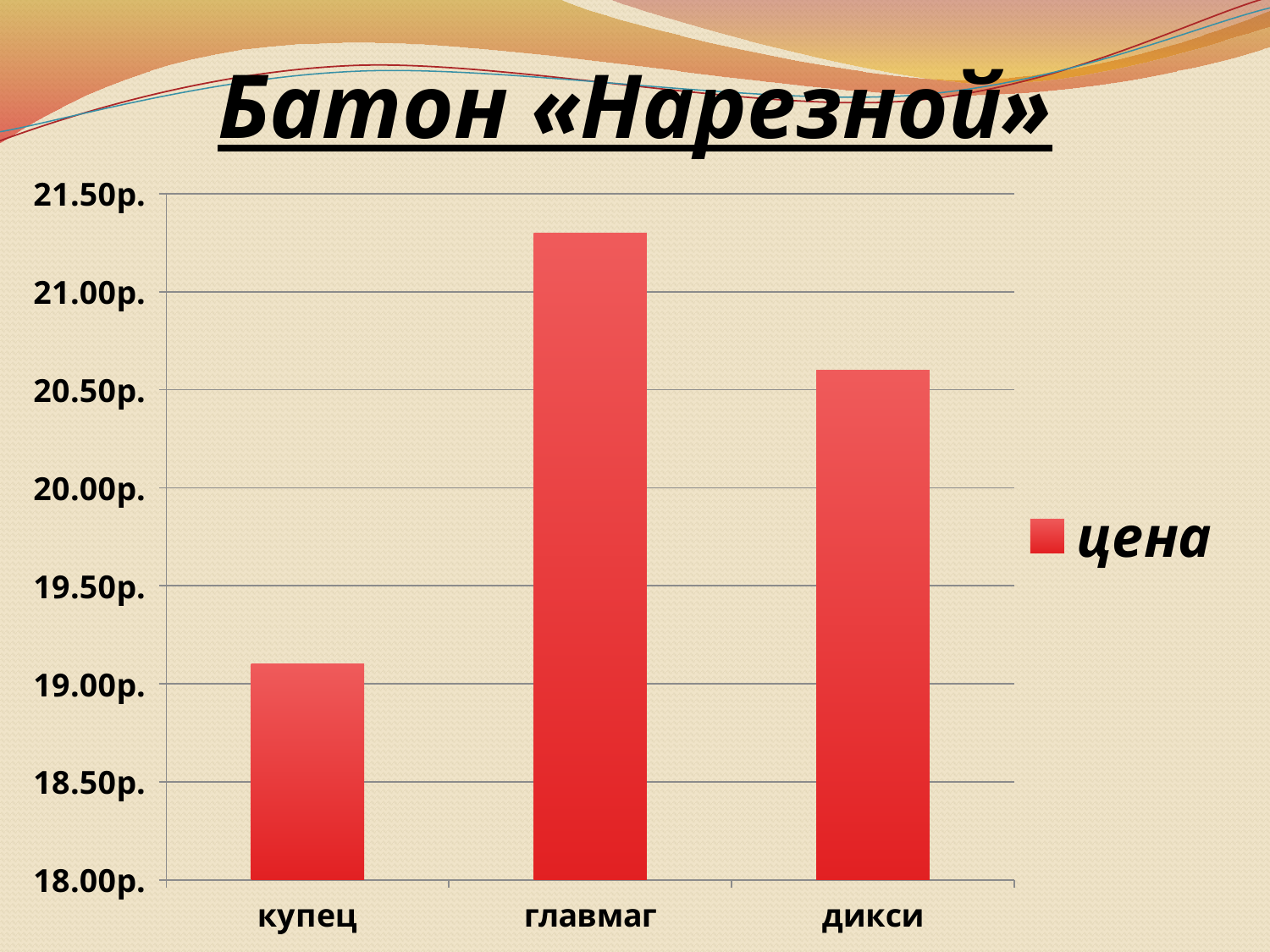
Which has a higher price, главмаг or дикси? главмаг Is the value for дикси greater or less than 21.00р.? less Which category has the highest price? главмаг Which category has the lowest price? купец How many series does the legend list? 1 How many categories are shown on the x axis of the chart? 3 What kind of chart is shown on the slide? bar chart Is the value for главмаг greater or less than 21.00р.? greater Which has a higher price, купец or дикси? дикси What is the name of the series shown in the legend? цена Is the value for купец greater or less than 19.50р.? less What is the title of the chart on the slide? Батон «Нарезной»